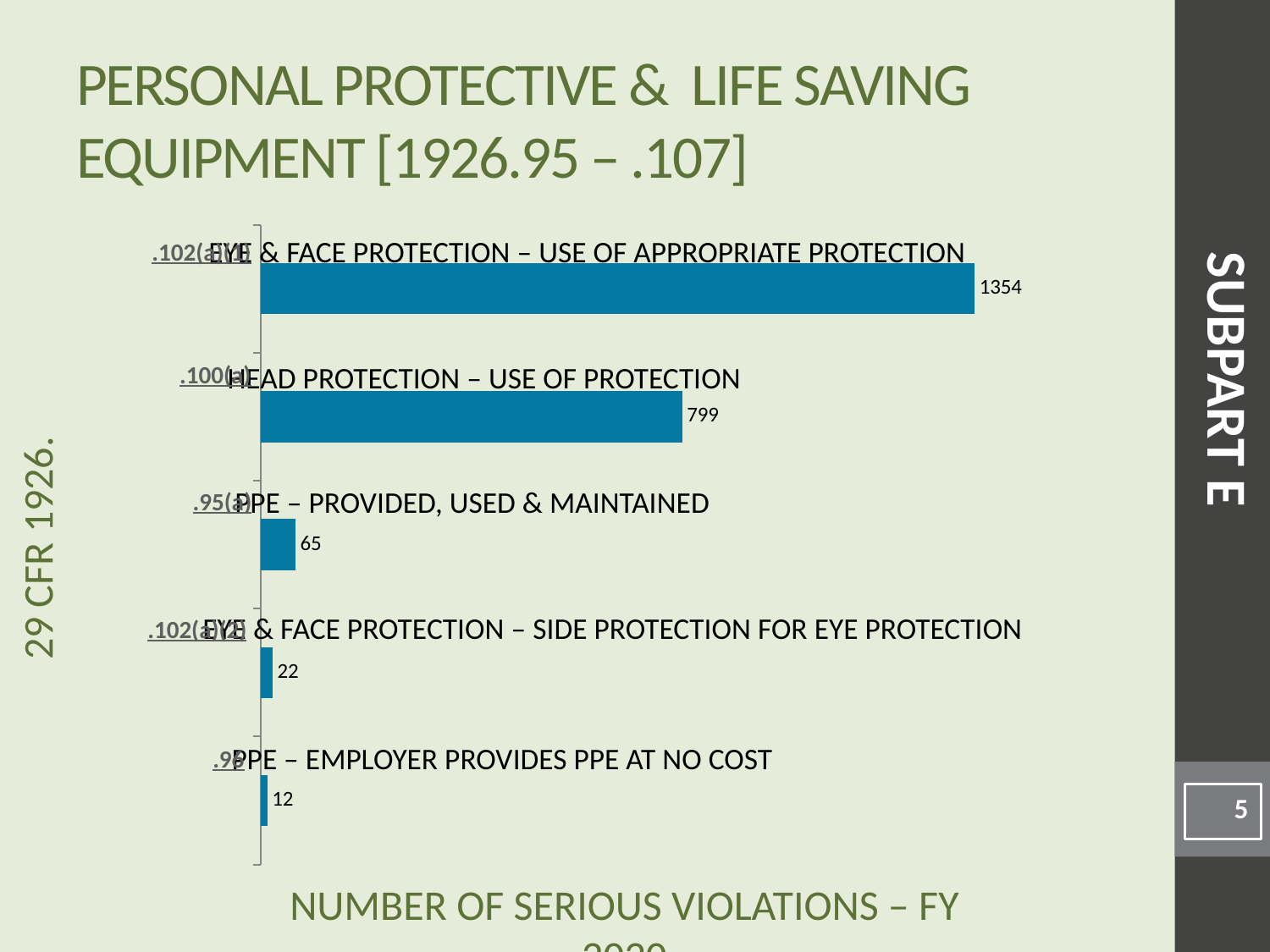
Which category has the highest number of serious violations? EYE & FACE PROTECTION – USE OF APPROPRIATE PROTECTION What is the value shown for PPE – PROVIDED, USED & MAINTAINED? 65 What colour are the bars in the chart? blue What kind of chart is shown on the slide? bar chart What is the number of serious violations for EYE & FACE PROTECTION – USE OF APPROPRIATE PROTECTION? 1354 What is the number of serious violations for HEAD PROTECTION – USE OF PROTECTION? 799 How many categories (bars) does the chart show? 5 What is the value shown for PPE – EMPLOYER PROVIDES PPE AT NO COST? 12 What is the difference between the values for EYE & FACE PROTECTION – USE OF APPROPRIATE PROTECTION and HEAD PROTECTION – USE OF PROTECTION? 555 Which category has the lowest number of serious violations? PPE – EMPLOYER PROVIDES PPE AT NO COST What is the value shown for EYE & FACE PROTECTION – SIDE PROTECTION FOR EYE PROTECTION? 22 Which is larger: the value for PPE – PROVIDED, USED & MAINTAINED or the value for EYE & FACE PROTECTION – SIDE PROTECTION FOR EYE PROTECTION? PPE – PROVIDED, USED & MAINTAINED